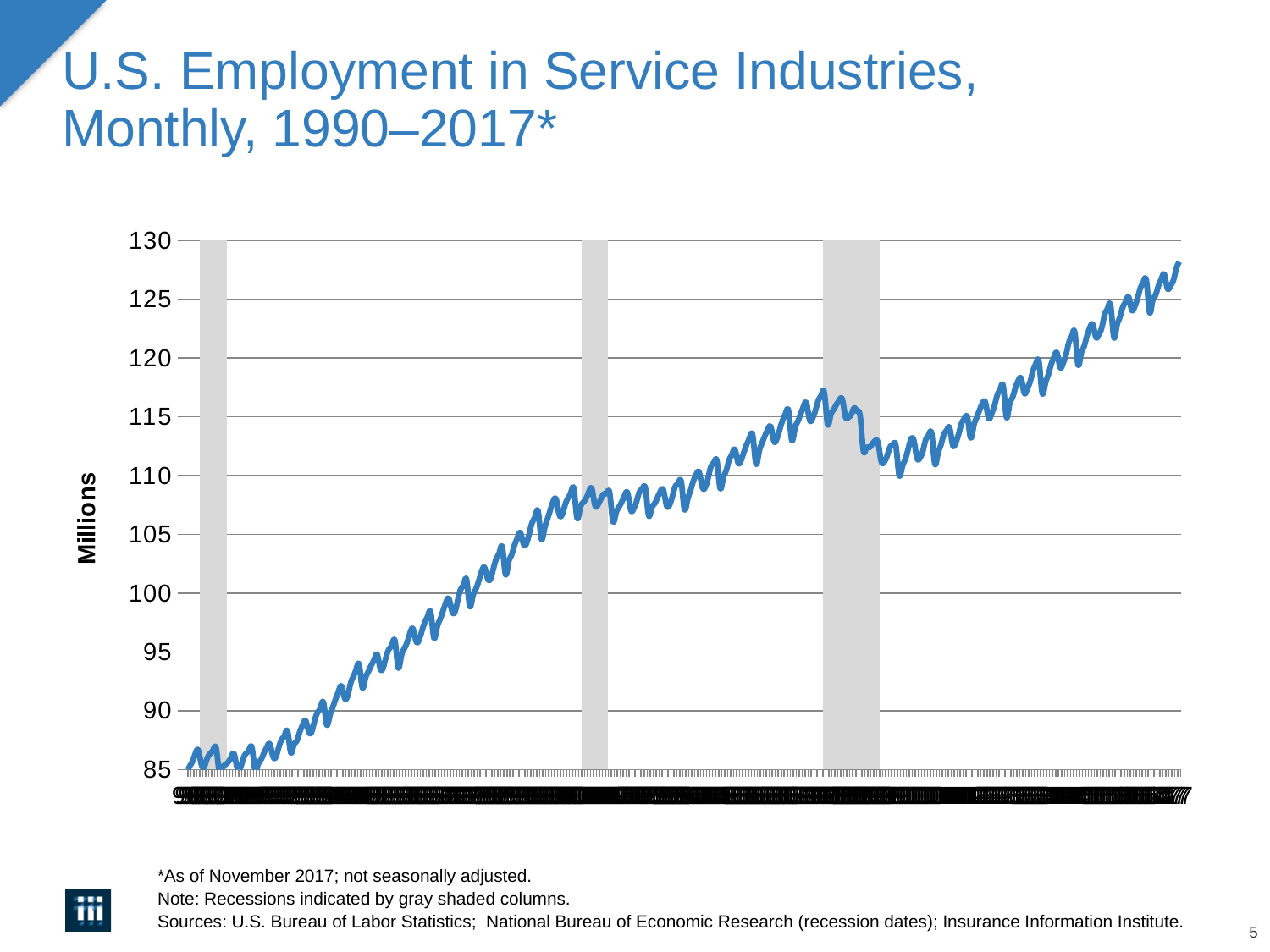
What is the title of the chart on the slide? U.S. Employment in Service Industries, Monthly, 1990–2017* Is the value at the start of the series (left end of the line) greater or less than 90? less Is the highest point on the line greater or less than 125? greater Is the value at the end of the series (right end of the line) greater or less than 125? greater What is the highest value shown on the vertical axis? 130 Overall, do the values rise or fall from left to right along the x axis? rise What kind of chart is shown on the slide? line chart What is the label on the vertical axis of the chart? Millions Is the value at the end of the series greater or less than the value at the start of the series? greater